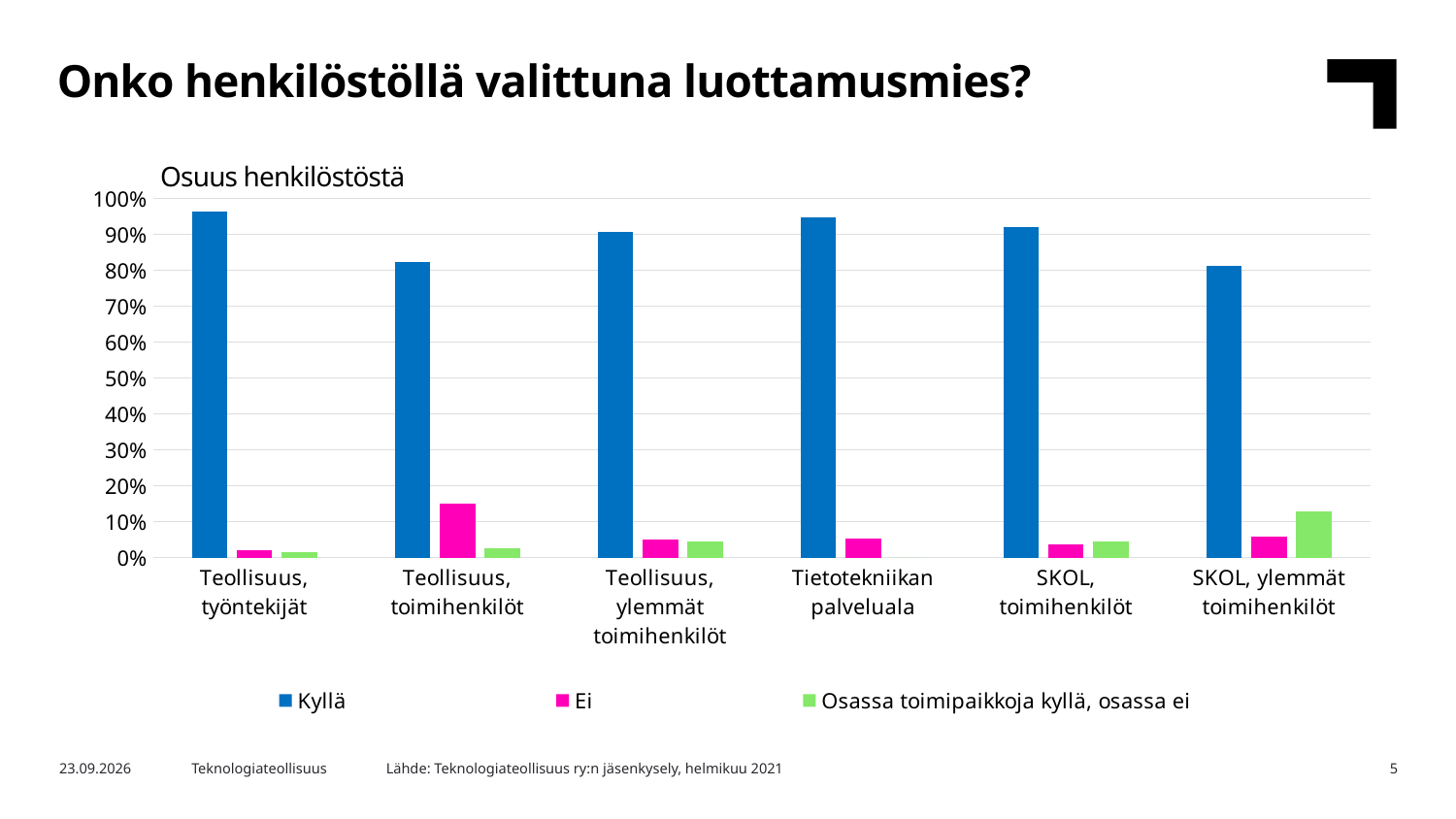
What kind of chart is shown on the slide? Bar chart Which category has the highest value for the 'Osassa toimipaikkoja kyllä, osassa ei' series? SKOL, ylemmät toimihenkilöt How many series does the chart's legend list? 3 Is the 'Kyllä' value for Teollisuus, toimihenkilöt greater or less than 90%? less Which is larger: the 'Kyllä' value for Teollisuus, työntekijät or for Teollisuus, toimihenkilöt? Teollisuus, työntekijät Is the 'Ei' value for Teollisuus, toimihenkilöt greater or less than 10%? greater How many categories are shown on the x axis of the chart? 6 Is the 'Osassa toimipaikkoja kyllä, osassa ei' value for SKOL, ylemmät toimihenkilöt greater or less than 10%? greater What is the title shown above the chart's vertical axis? Osuus henkilöstöstä Which is larger: the 'Ei' value for Teollisuus, toimihenkilöt or for Teollisuus, työntekijät? Teollisuus, toimihenkilöt Which category has the highest value for the 'Ei' series? Teollisuus, toimihenkilöt